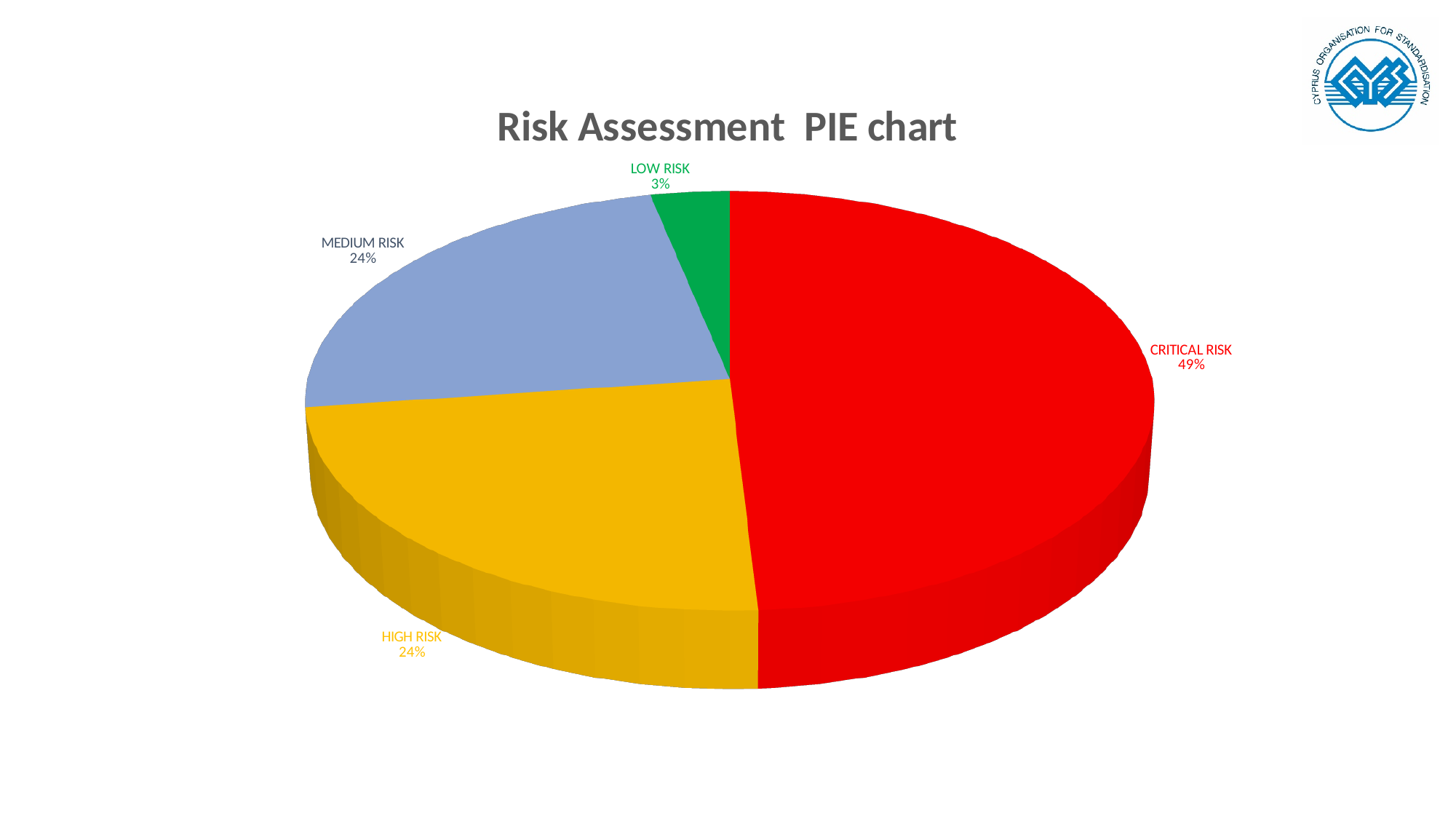
What is the difference in percentage points between CRITICAL RISK and LOW RISK? 46 How many categories are shown in the pie chart? 4 Which category has the largest share of the pie? CRITICAL RISK Which category has the smallest share of the pie? LOW RISK What percentage of the pie is HIGH RISK? 24% What is the difference in percentage points between CRITICAL RISK and MEDIUM RISK? 25 What percentage of the pie is CRITICAL RISK? 49% What is the title of the chart? Risk Assessment PIE chart What percentage of the pie is MEDIUM RISK? 24% Which is larger, the share for CRITICAL RISK or the share for HIGH RISK? CRITICAL RISK What percentage of the pie is LOW RISK? 3% What kind of chart is shown on the slide? Pie chart